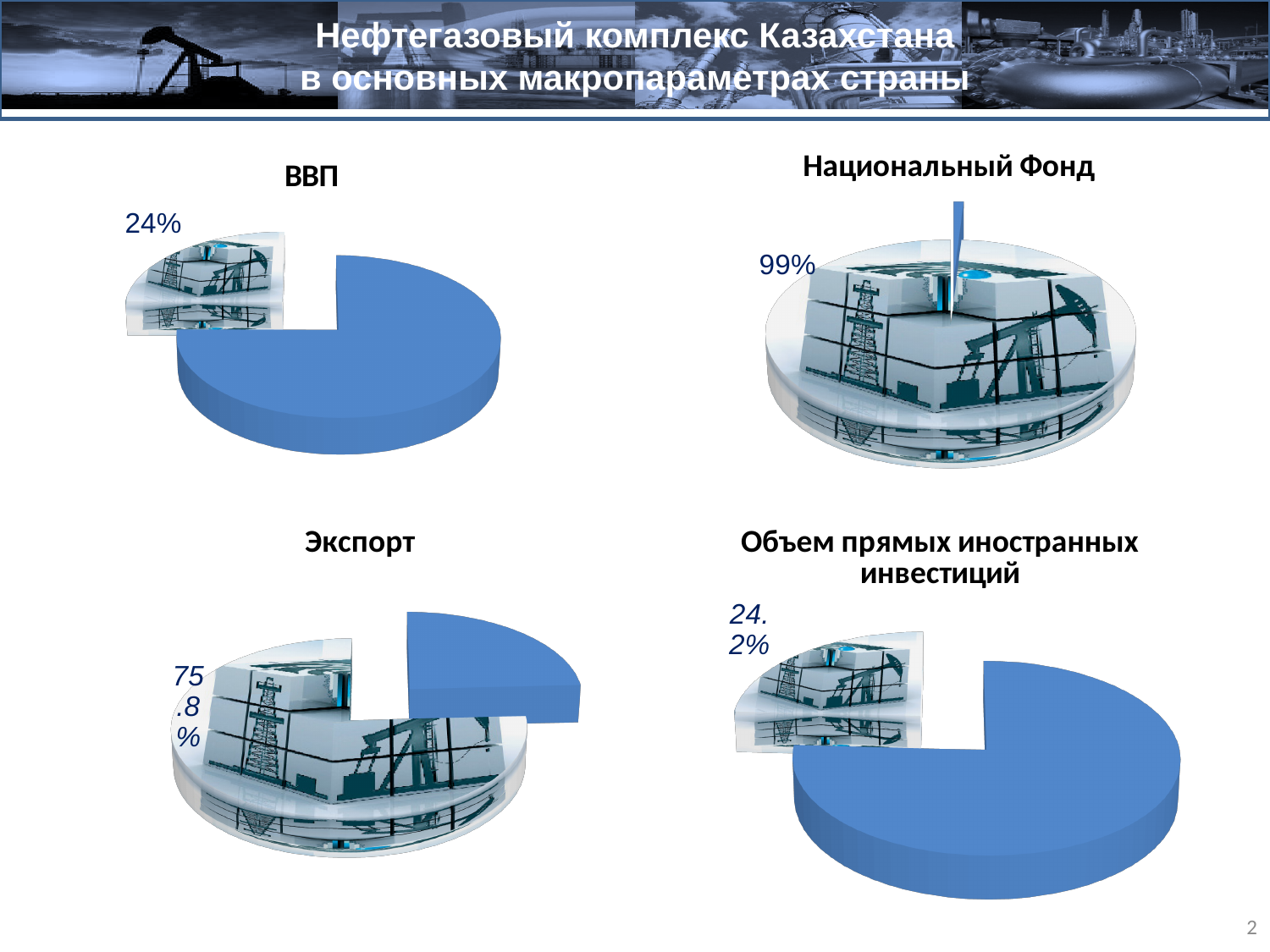
What is the title of the chart in the bottom-right of the slide? Объем прямых иностранных инвестиций In the chart titled ВВП, what percentage is printed on the labelled slice? 24% How many pie charts are shown on the slide? 4 Which chart on the slide shows the smallest labelled percentage? ВВП Which chart on the slide shows the largest labelled percentage? Национальный Фонд In the chart titled Объем прямых иностранных инвестиций, what percentage is printed on the labelled slice? 24.2% What is the title of the chart in the top-right of the slide? Национальный Фонд Which labelled percentage is larger: the one in the Экспорт chart or the one in the ВВП chart? Экспорт What kind of chart is used for ВВП on this slide? Pie chart In the chart titled Экспорт, what percentage is printed on the labelled slice? 75.8% How many slices does the pie chart titled Экспорт have? 2 In the chart titled Национальный Фонд, what percentage is printed on the labelled slice? 99%